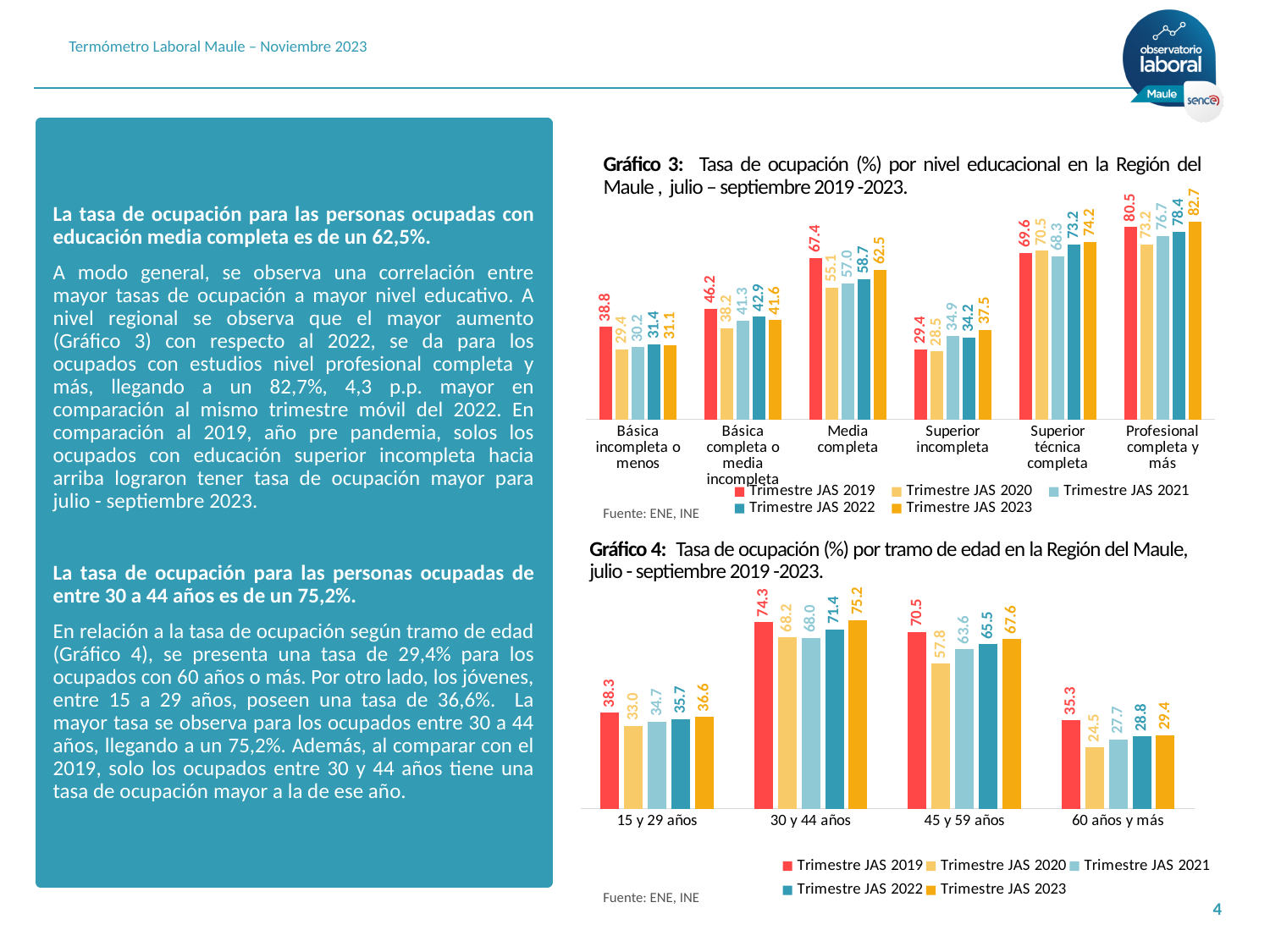
In Gráfico 4, what is the occupation rate for '30 y 44 años' in Trimestre JAS 2023? 75,2 What kind of chart is Gráfico 4? bar chart In Gráfico 3, which education level has the lowest occupation rate in Trimestre JAS 2020? Superior incompleta In Gráfico 3, how many series does the legend list? 5 In Gráfico 4, which age group has the lowest occupation rate in Trimestre JAS 2023? 60 años y más In Gráfico 3, what is the occupation rate for 'Profesional completa y más' in Trimestre JAS 2019? 80,5 In Gráfico 3, what is the difference between the Trimestre JAS 2023 and Trimestre JAS 2022 values for 'Profesional completa y más'? 4,3 In Gráfico 3, how many education level categories are shown on the x axis? 6 In Gráfico 4, is the Trimestre JAS 2019 value for '45 y 59 años' larger or smaller than the Trimestre JAS 2023 value for the same group? larger In Gráfico 3, what is the occupation rate for 'Media completa' in Trimestre JAS 2023? 62,5 In Gráfico 3, which education level has the highest occupation rate in Trimestre JAS 2023? Profesional completa y más In Gráfico 4, what is the occupation rate for '60 años y más' in Trimestre JAS 2020? 24,5